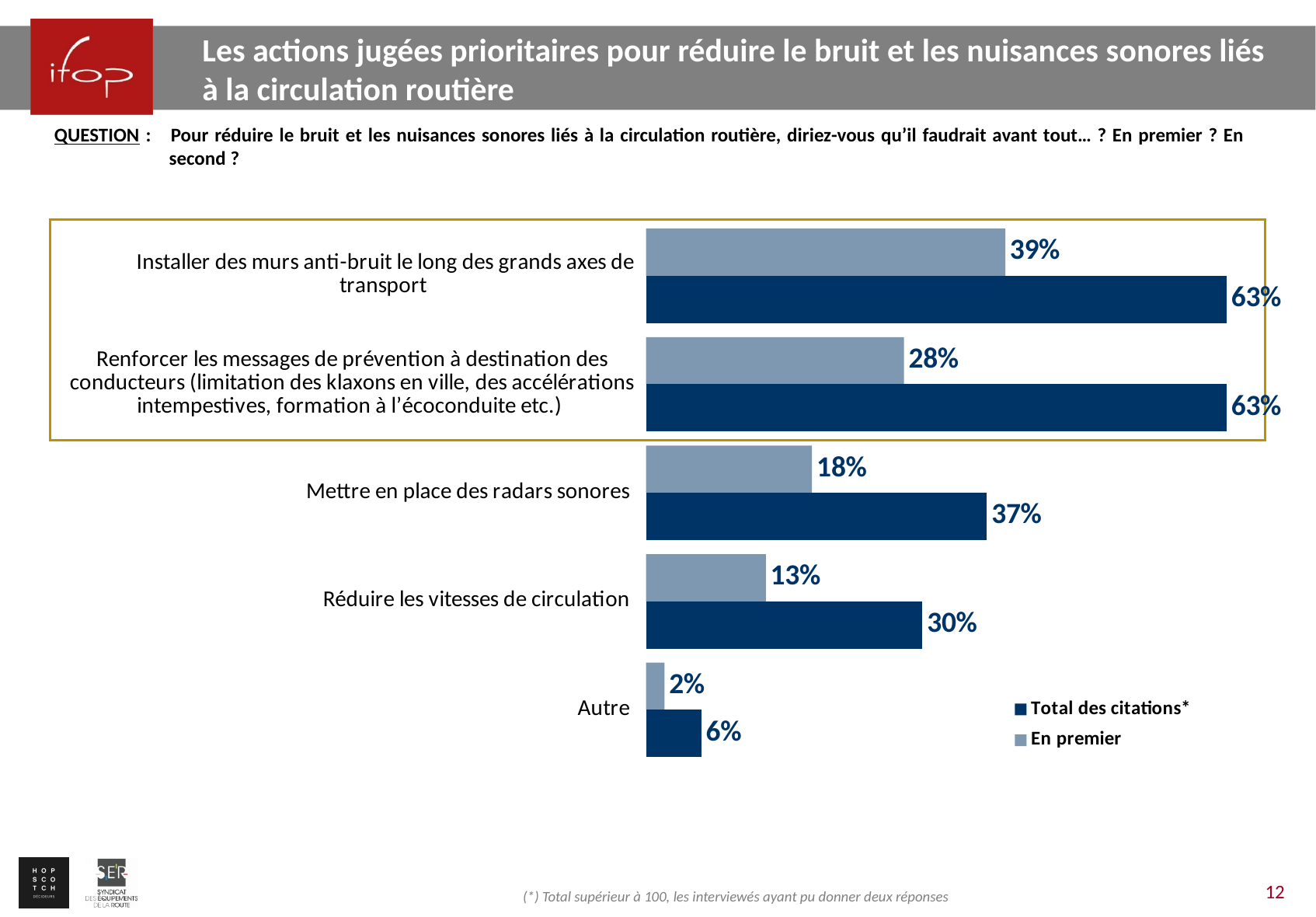
What kind of chart is shown on the slide? Bar chart How many series does the legend list? 2 What is the "En premier" value for "Réduire les vitesses de circulation"? 13% Which category has the highest "En premier" value? Installer des murs anti-bruit le long des grands axes de transport Which series is shown in dark blue in the legend? Total des citations* Which category has the lowest "Total des citations*" value? Autre What is the difference between the "Total des citations*" and "En premier" values for "Renforcer les messages de prévention à destination des conducteurs"? 35 percentage points Which is larger: the "En premier" value for "Mettre en place des radars sonores" or for "Réduire les vitesses de circulation"? Mettre en place des radars sonores How many categories are shown in the chart? 5 What is the "Total des citations*" value for "Autre"? 6% What is the "En premier" value for "Installer des murs anti-bruit le long des grands axes de transport"? 39% What is the "Total des citations*" value for "Mettre en place des radars sonores"? 37%